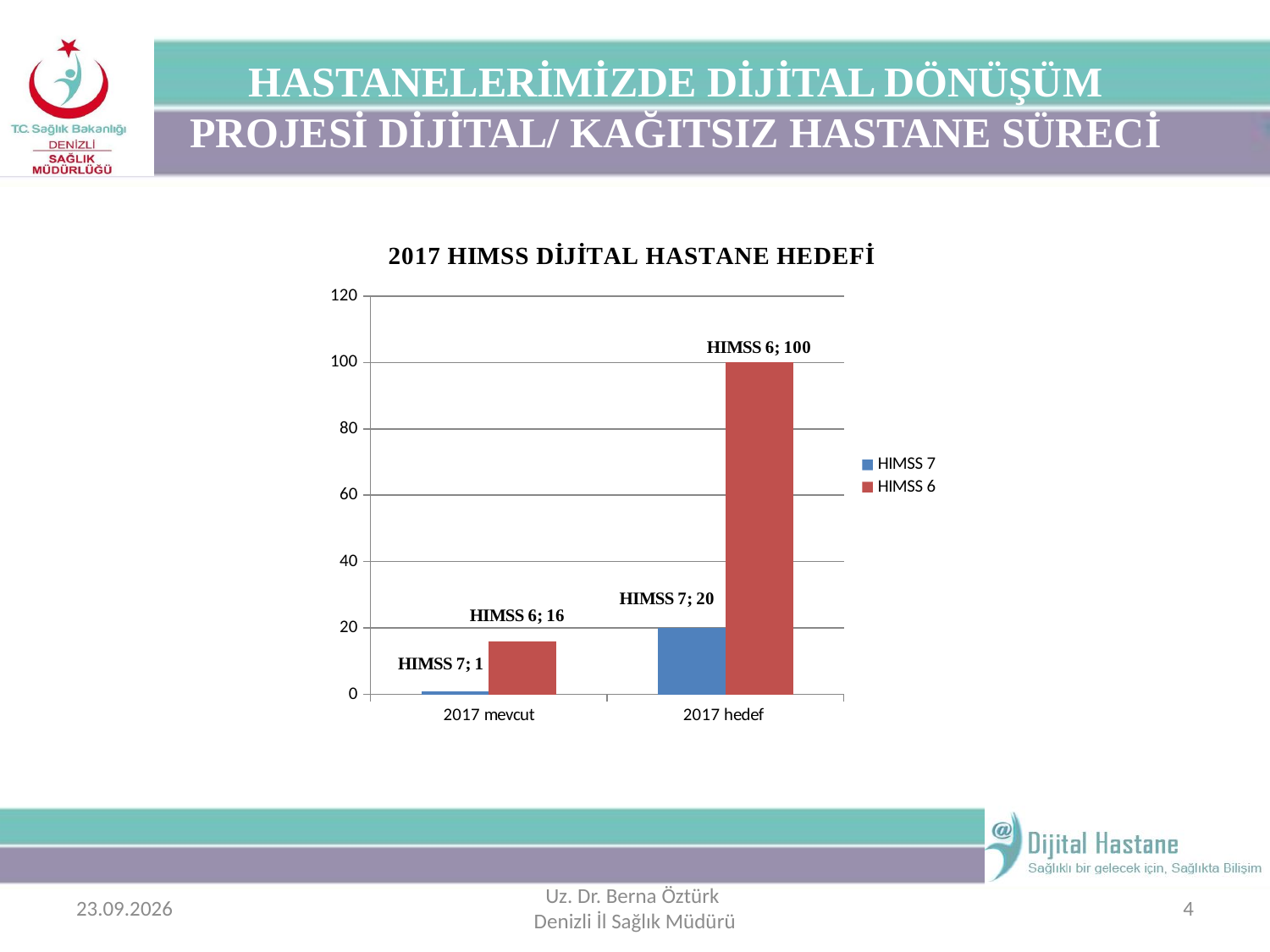
Which category has the highest HIMSS 6 value? 2017 hedef What is the value for HIMSS 7 in the 2017 hedef category? 20 What is the value for HIMSS 7 in the 2017 mevcut category? 1 How many categories are shown on the x axis? 2 Which category has the lowest HIMSS 7 value? 2017 mevcut What is the title of the chart? 2017 HIMSS DİJİTAL HASTANE HEDEFİ Which is larger in the 2017 hedef category, HIMSS 7 or HIMSS 6? HIMSS 6 What is the value for HIMSS 6 in the 2017 hedef category? 100 What is the difference between the HIMSS 6 values for 2017 hedef and 2017 mevcut? 84 What is the value for HIMSS 6 in the 2017 mevcut category? 16 What kind of chart is shown on the slide? Bar chart How many series does the legend list? 2